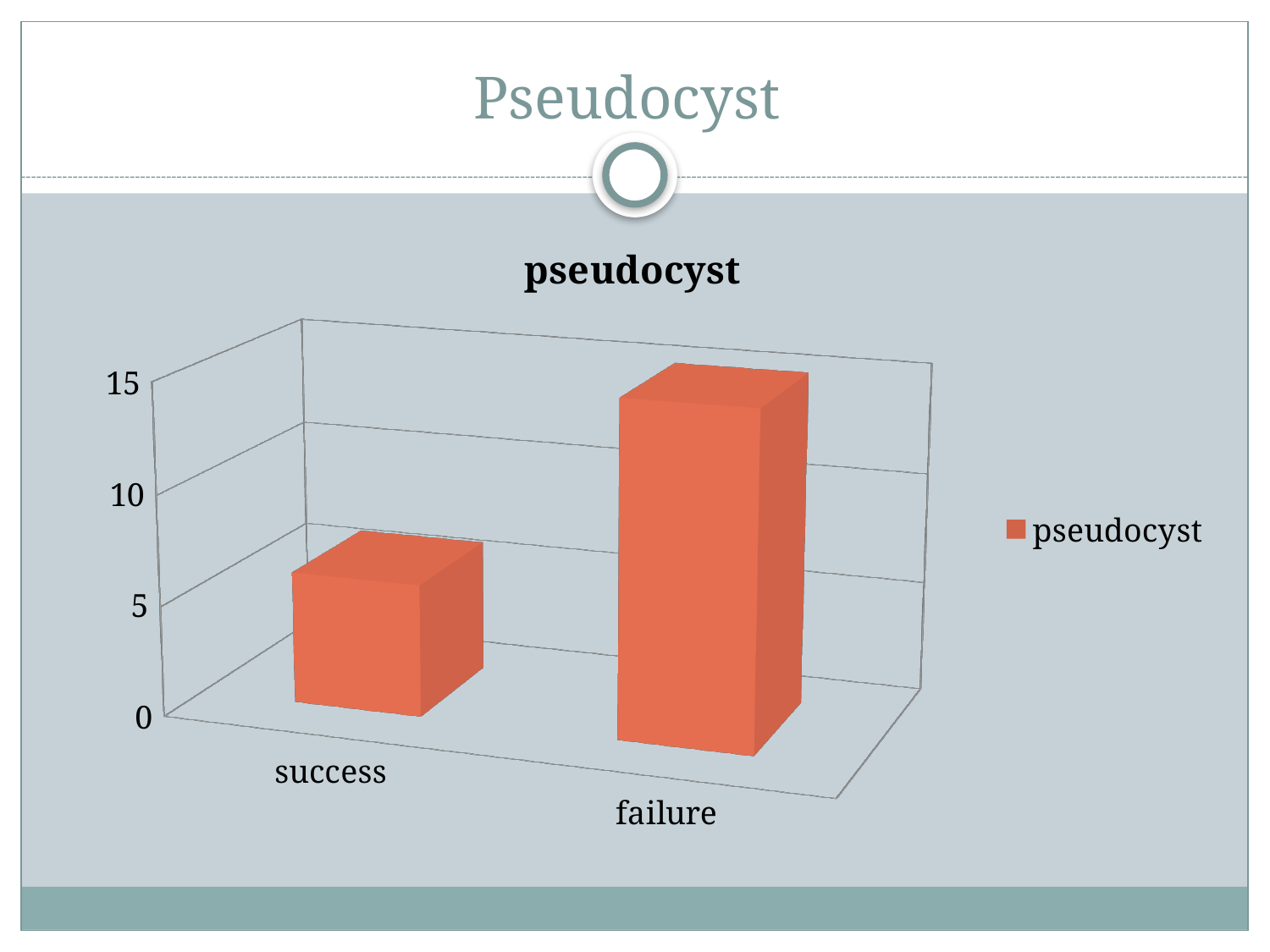
Which category has the highest value? failure What is the title of the chart? pseudocyst Which category has the lowest value? success Is the value for success greater or less than 10? less How many categories are plotted in the chart? 2 Is the value for failure greater or less than 10? greater What kind of chart is shown on the slide? bar chart How many series does the legend list? 1 What is the name of the series shown in the legend? pseudocyst Do the values rise or fall from success to failure along the x axis? rise Which is larger, the value for success or the value for failure? failure